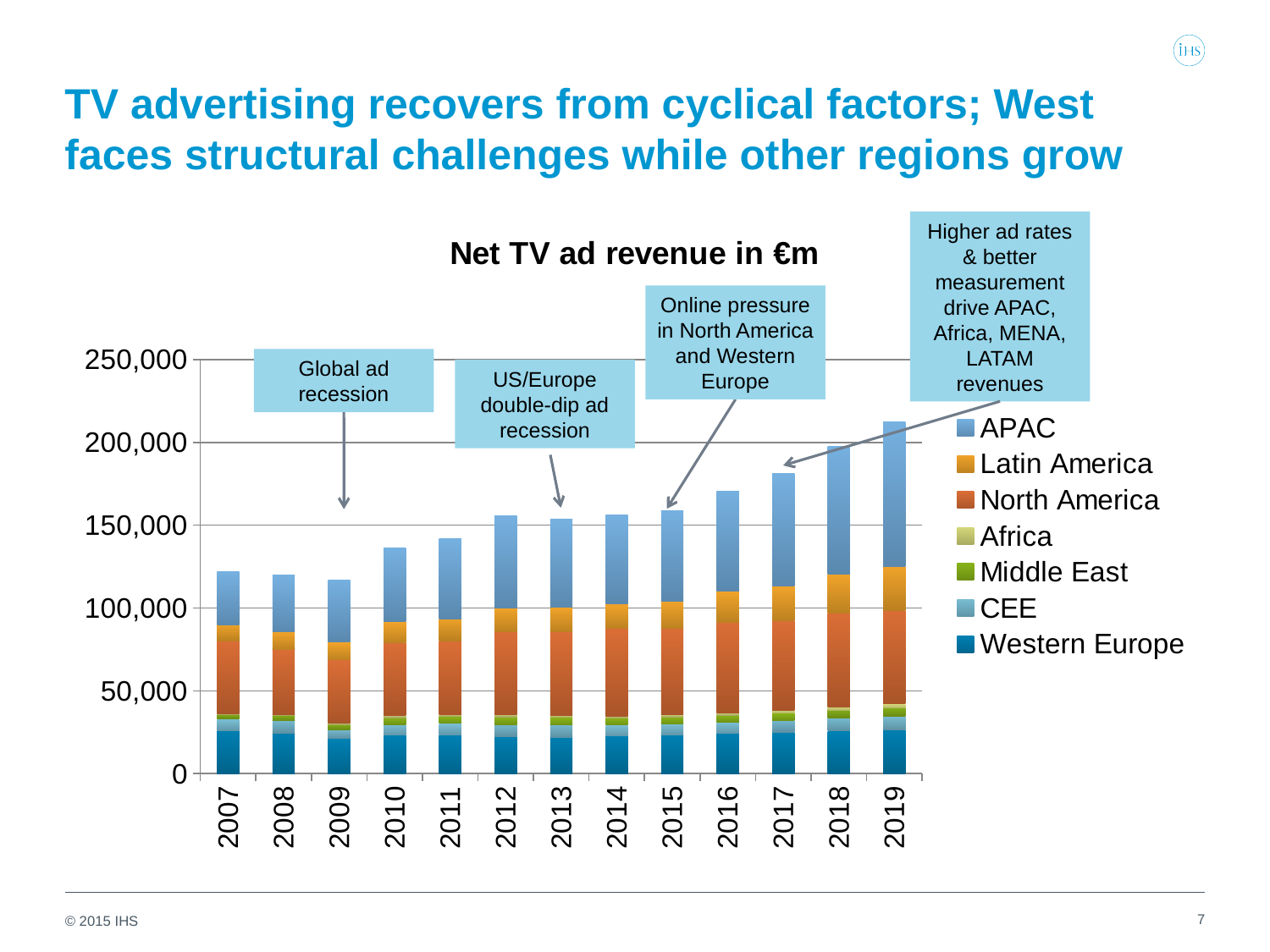
Is the total net TV ad revenue for 2019 greater or less than 200,000? greater Which year has the highest total net TV ad revenue? 2019 How many years are shown on the x axis? 13 Is the total net TV ad revenue for 2017 greater or less than 150,000? greater Do total net TV ad revenues generally rise or fall from 2007 to 2019? rise Is the total net TV ad revenue for 2007 greater or less than 100,000? greater What kind of chart is shown on the slide? Stacked bar chart Which year has the larger total net TV ad revenue, 2007 or 2019? 2019 How many series does the legend list? 7 Which region is listed first in the legend? APAC What is the title of the chart? Net TV ad revenue in €m